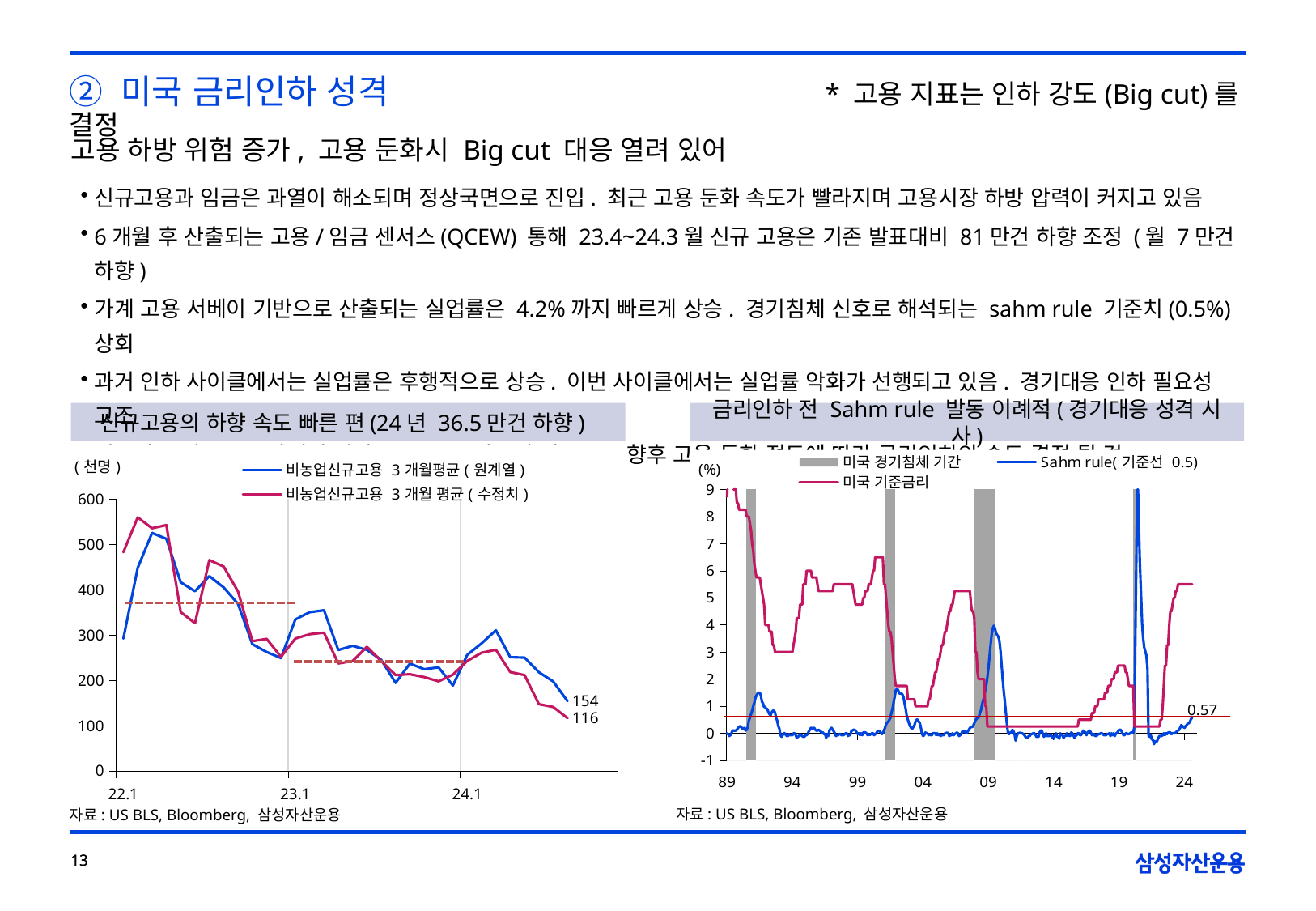
In the right chart (금리인하 전 Sahm rule 발동 이례적), how many entries does the legend list? 3 In the left chart (신규고용의 하향 속도 빠른 편), what is the last labelled value of the 비농업신규고용 3개월 평균 (수정치) series? 116 What kind of chart is the left chart titled '신규고용의 하향 속도 빠른 편'? line chart In the left chart (신규고용의 하향 속도 빠른 편), do the values generally rise or fall from 22.1 to 24.1? fall In the left chart (신규고용의 하향 속도 빠른 편), what is the last labelled value of the 비농업신규고용 3개월평균 (원계열) series? 154 In the left chart (신규고용의 하향 속도 빠른 편), what is the difference between the two labelled end values, 154 and 116? 38 In the left chart (신규고용의 하향 속도 빠른 편), what unit is shown on the y axis? 천명 In the right chart (금리인하 전 Sahm rule 발동 이례적), what is the labelled latest value of the Sahm rule series? 0.57 In the right chart (금리인하 전 Sahm rule 발동 이례적), is the 미국 기준금리 value at 24 greater or less than 5? greater In the left chart (신규고용의 하향 속도 빠른 편), is the 원계열 value at 22.1 greater or less than 400? less In the left chart (신규고용의 하향 속도 빠른 편), how many series does the legend list? 2 In the left chart (신규고용의 하향 속도 빠른 편), which series has the higher labelled end value, 원계열 or 수정치? 원계열